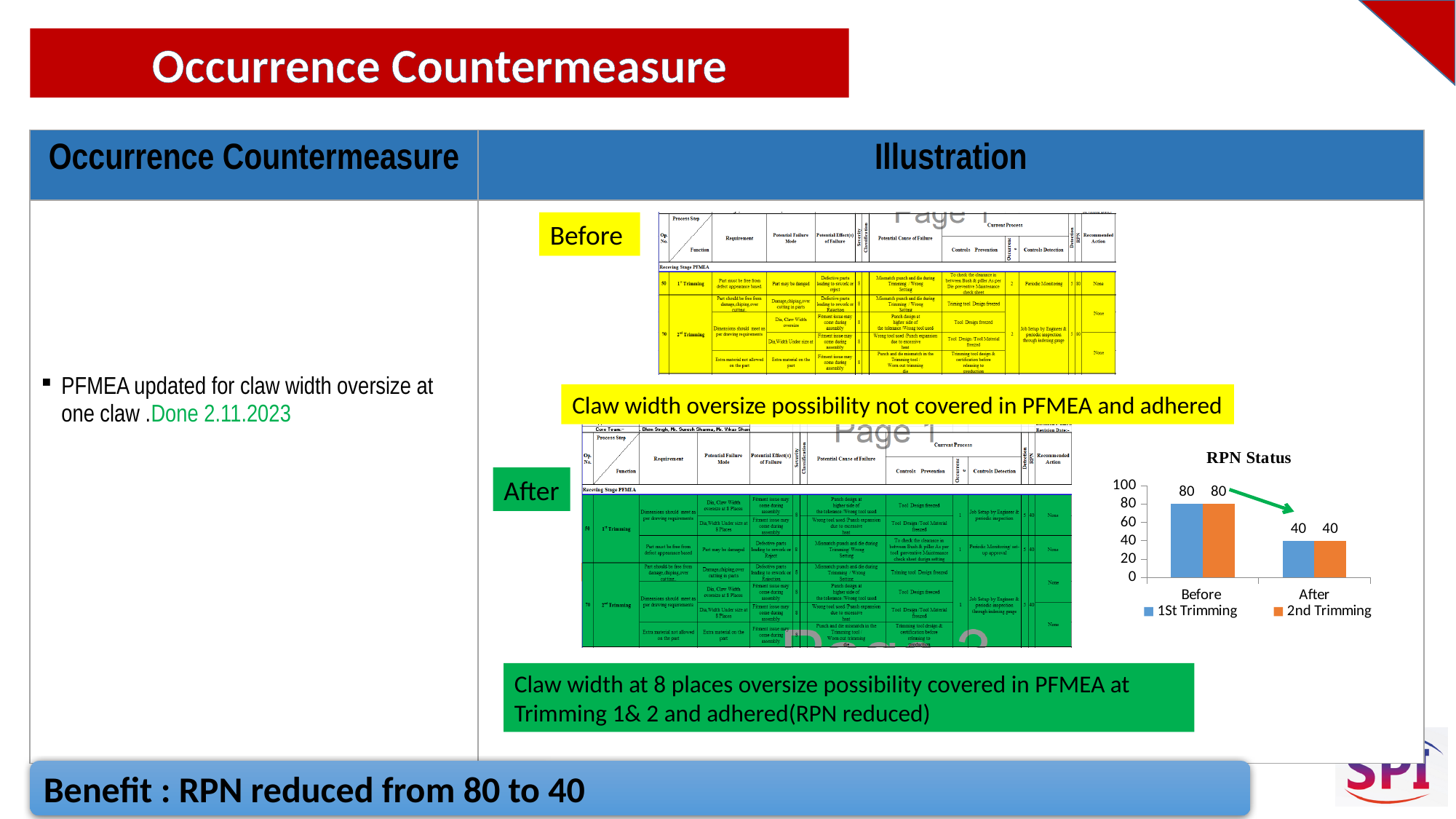
What type of chart is the RPN Status chart? bar chart Do the RPN values rise or fall from Before to After? fall Is the 1St Trimming value for After greater or less than 60? less Which category has the lowest 1St Trimming value? After Which category has the higher 2nd Trimming value, Before or After? Before How many series does the legend of the RPN Status chart list? 2 What is the difference between the 1St Trimming value Before and After? 40 What is the value for 2nd Trimming in the After category? 40 How many categories are shown on the x axis of the RPN Status chart? 2 What colour represents 2nd Trimming in the RPN Status chart? orange What is the value for 1St Trimming in the Before category? 80 What is the title of the chart on the slide? RPN Status